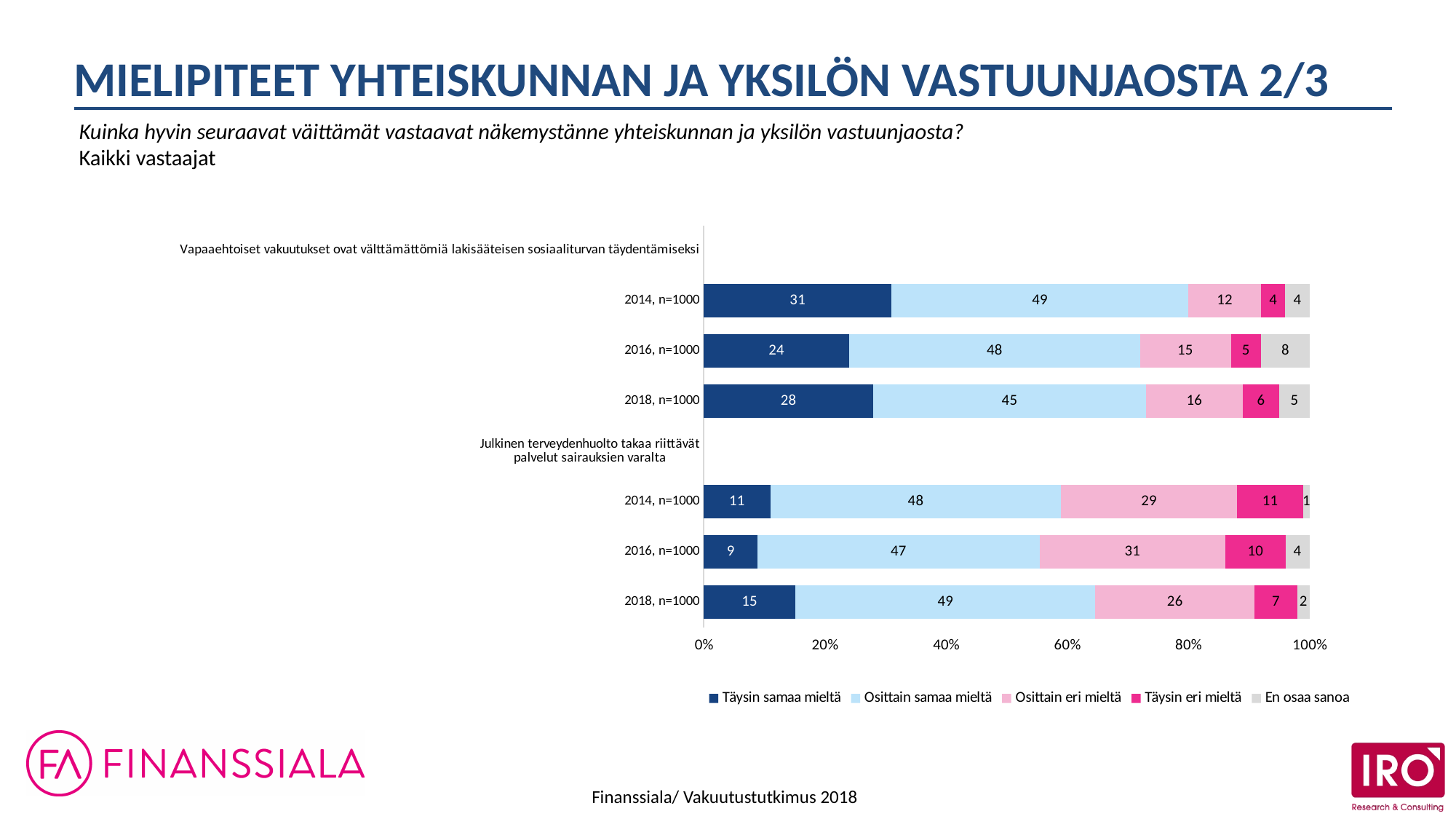
What is the 'Osittain eri mieltä' value for 2016 under the statement 'Julkinen terveydenhuolto takaa riittävät palvelut sairauksien varalta'? 31 What is the total of the 2014 bar under the statement 'Vapaaehtoiset vakuutukset ovat välttämättömiä lakisääteisen sosiaaliturvan täydentämiseksi'? 100 For the statement 'Julkinen terveydenhuolto takaa riittävät palvelut sairauksien varalta', which year has the lowest 'Täysin samaa mieltä' value? 2016 For the statement 'Vapaaehtoiset vakuutukset ovat välttämättömiä lakisääteisen sosiaaliturvan täydentämiseksi', which year has the highest 'Täysin samaa mieltä' value? 2014 For the statement 'Vapaaehtoiset vakuutukset ovat välttämättömiä lakisääteisen sosiaaliturvan täydentämiseksi', what is the difference between the 'Täysin samaa mieltä' values for 2014 and 2016? 7 How many series does the legend list? 5 What is the 'Täysin samaa mieltä' value for 2014 under the statement 'Vapaaehtoiset vakuutukset ovat välttämättömiä lakisääteisen sosiaaliturvan täydentämiseksi'? 31 What kind of chart is shown on the slide? Stacked bar chart What is the highest value shown on the x axis? 100% For the statement 'Julkinen terveydenhuolto takaa riittävät palvelut sairauksien varalta', which year has the larger 'Osittain eri mieltä' value, 2014 or 2018? 2014 What is the 'En osaa sanoa' value for 2016 under the statement 'Vapaaehtoiset vakuutukset ovat välttämättömiä lakisääteisen sosiaaliturvan täydentämiseksi'? 8 How many bars are plotted in the chart? 6